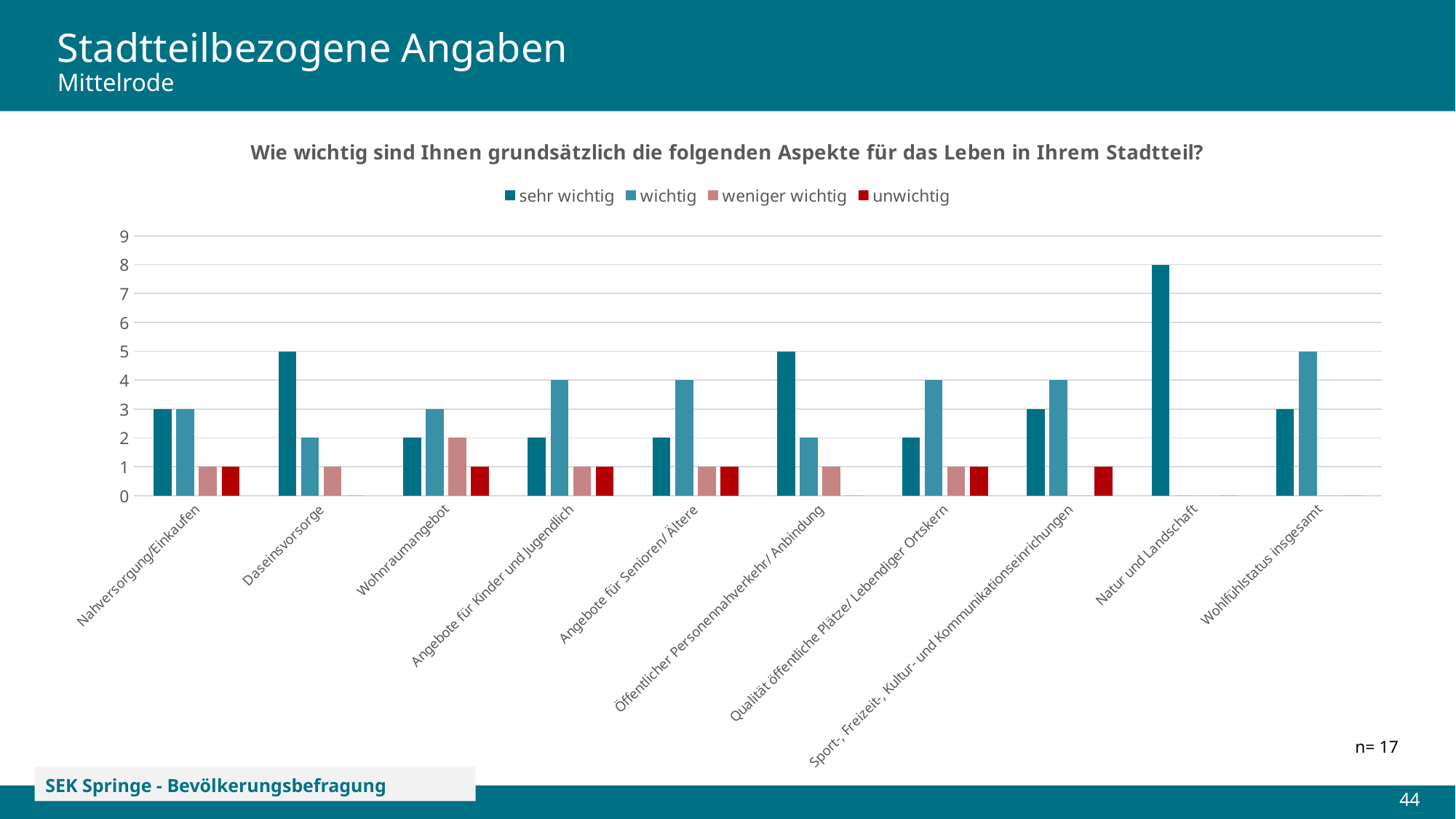
Is the value for 'sehr wichtig' for Natur und Landschaft greater or less than 5? greater How many series does the legend list? 4 How many categories are shown on the x axis? 10 What is the value for 'sehr wichtig' for Daseinsvorsorge? 5 What kind of chart is shown on the slide? bar chart Which category has the highest value for 'sehr wichtig'? Natur und Landschaft What is the difference between 'sehr wichtig' and 'wichtig' for Öffentlicher Personennahverkehr/ Anbindung? 3 What is the value for 'sehr wichtig' for Natur und Landschaft? 8 What is the title of the chart? Wie wichtig sind Ihnen grundsätzlich die folgenden Aspekte für das Leben in Ihrem Stadtteil? What is the value for 'wichtig' for Wohlfühlstatus insgesamt? 5 Which is larger for Angebote für Kinder und Jugendlich: 'sehr wichtig' or 'wichtig'? wichtig What is the value for 'weniger wichtig' for Wohnraumangebot? 2